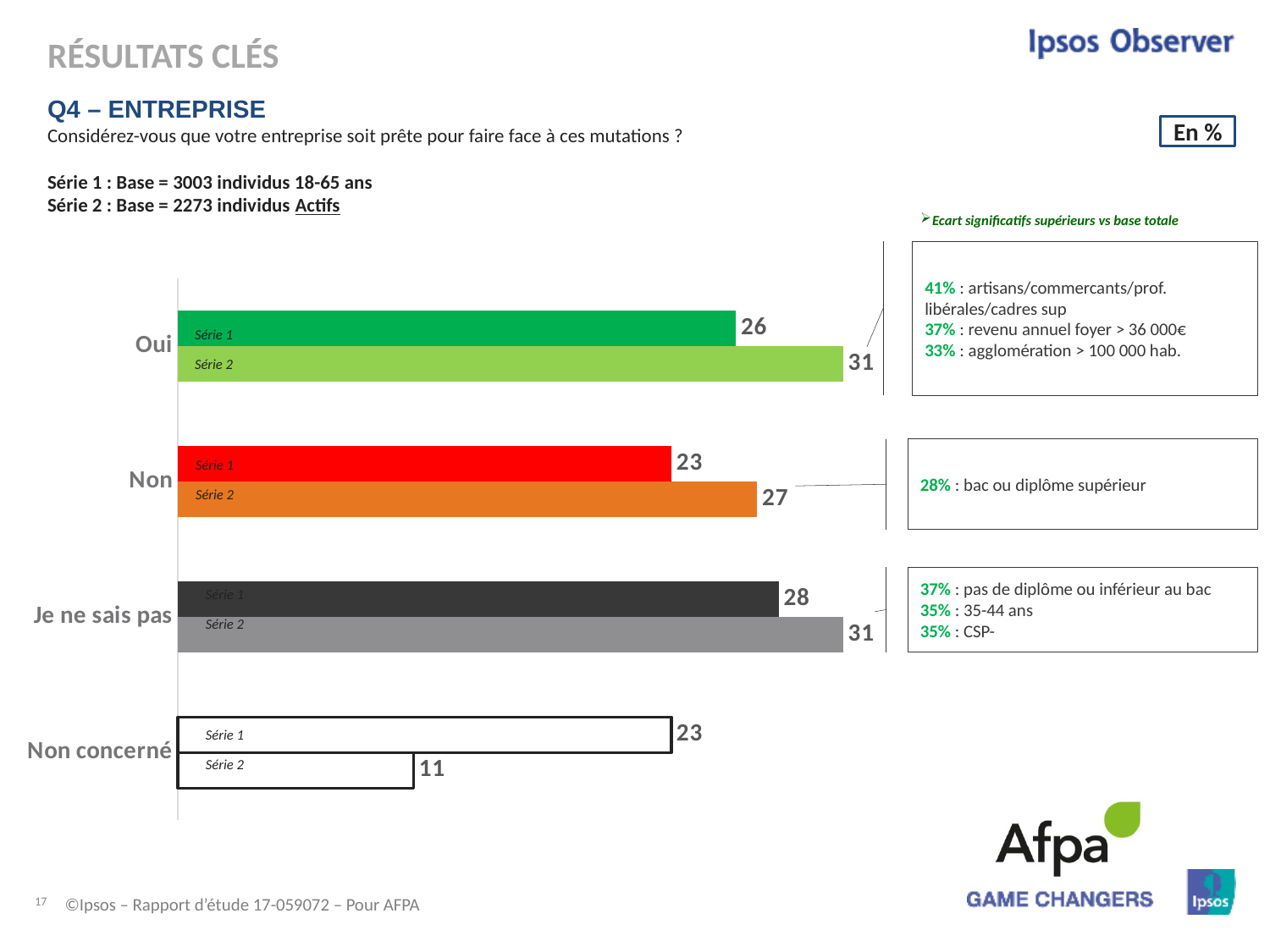
Which category has the highest Série 1 value? Je ne sais pas What type of chart is shown on the slide? Bar chart What is the Série 1 value for "Oui"? 26 What is the Série 2 value for "Non concerné"? 11 What is the difference between the Série 2 and Série 1 values for "Oui"? 5 For "Non", which is larger: the Série 1 value or the Série 2 value? Série 2 Which category has the lowest Série 2 value? Non concerné How many response categories are shown in the chart? 4 What is the difference between the Série 1 and Série 2 values for "Non concerné"? 12 How many series are plotted for each category? 2 What is the Série 2 value for "Non"? 27 What is the Série 1 value for "Je ne sais pas"? 28